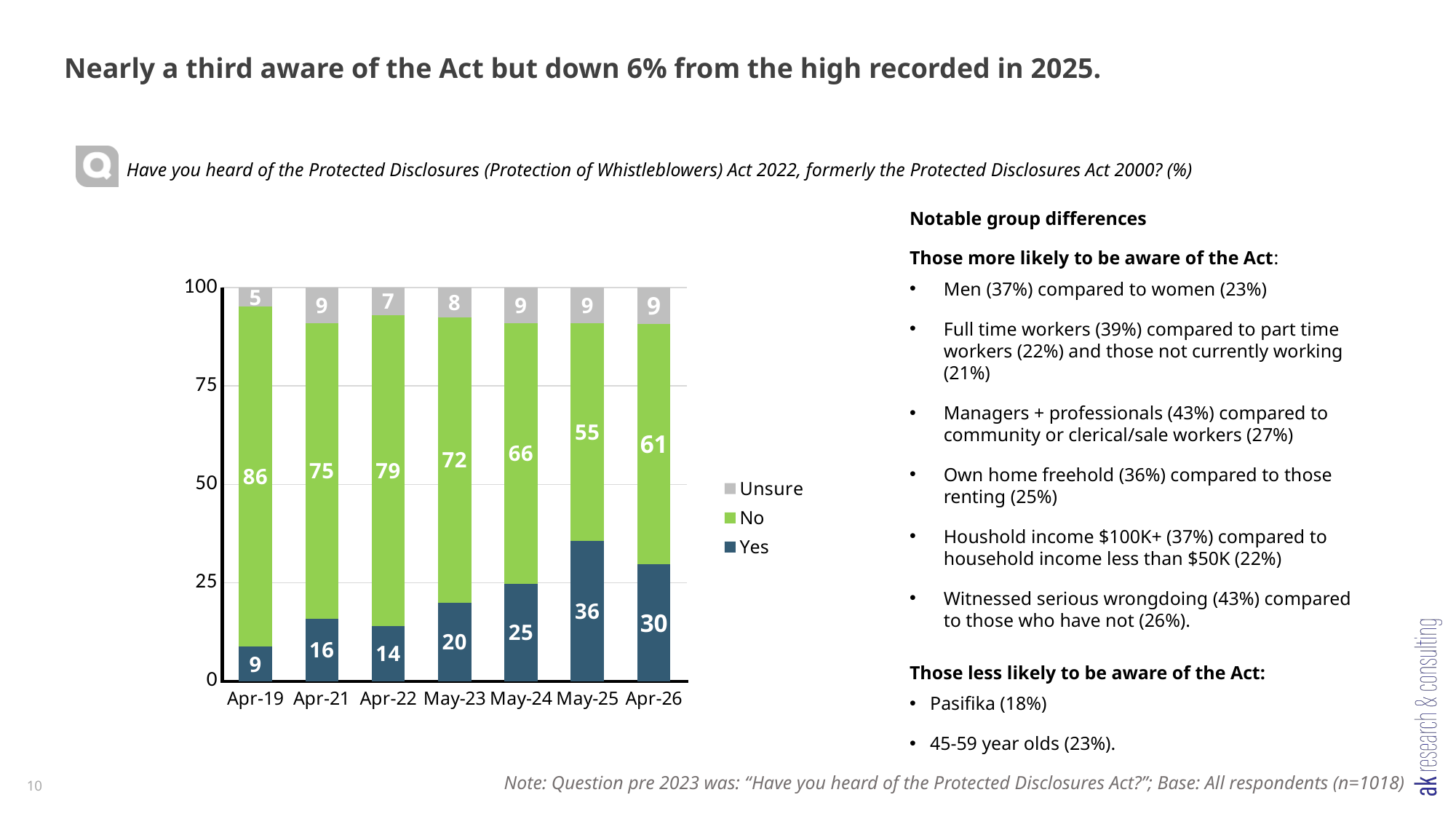
What kind of chart is shown on the slide? Stacked bar chart What is the 'Unsure' value for Apr-22? 7 In which period is the 'No' value lowest? May-25 Which is larger, the 'No' value for Apr-21 or the 'No' value for Apr-22? Apr-22 Which legend entry is shown in green? No In which period is the 'Yes' value highest? May-25 How many series does the legend list? 3 What is the total of the stacked bar for May-24? 100 What is the 'Yes' value for Apr-26? 30 How many time periods are shown on the x axis? 7 What is the difference between the 'Yes' values for May-25 and Apr-26? 6 What is the 'No' value for Apr-19? 86